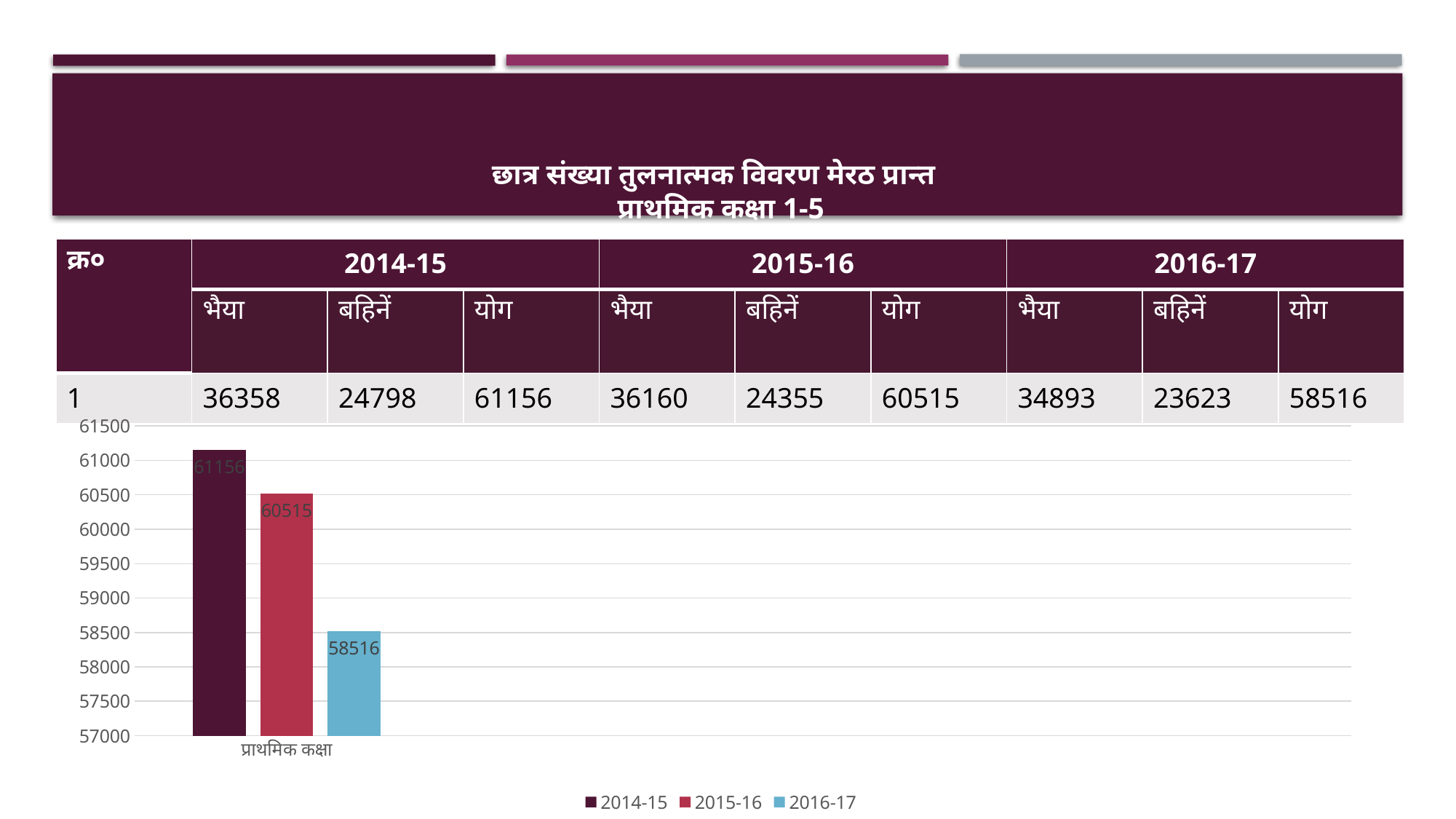
What is the difference between the 2014-15 and 2015-16 bars? 641 What is the value of the 2015-16 bar for प्राथमिक कक्षा? 60515 What type of chart is shown on the slide? bar chart How many series does the legend list? 3 What is the value of the 2016-17 bar for प्राथमिक कक्षा? 58516 What is the difference between the 2014-15 and 2016-17 bars? 2640 Which series has the highest bar in the chart? 2014-15 Is the value for 2016-17 greater or less than 59000? less What is the value of the 2014-15 bar for प्राथमिक कक्षा? 61156 Which series has the lowest bar in the chart? 2016-17 Do the bar values rise or fall from 2014-15 to 2016-17? fall Which is larger, the 2015-16 bar or the 2016-17 bar? 2015-16